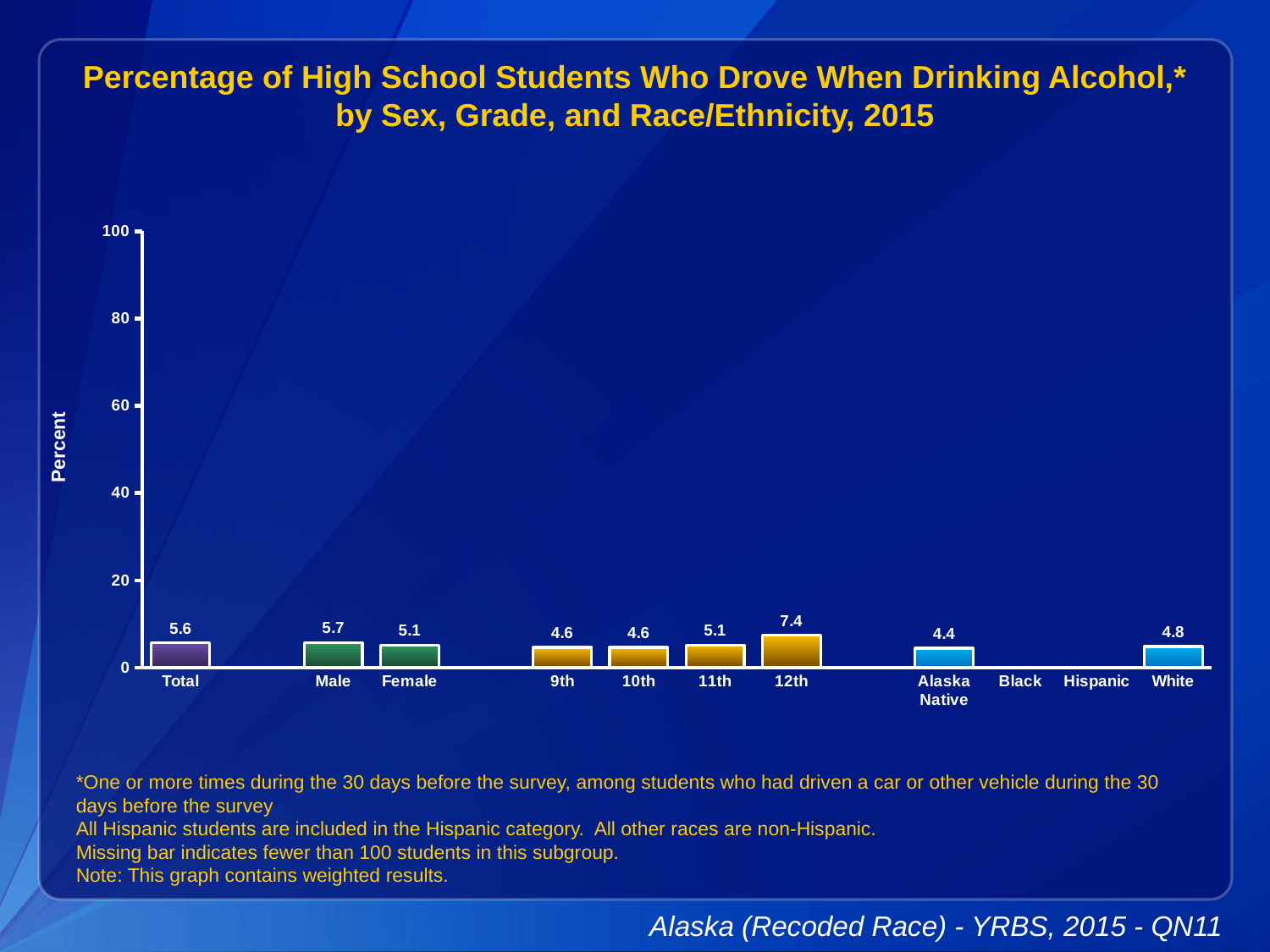
Which is larger, the value for 11th grade or the value for 12th grade? 12th Is the value for White greater or less than 20? less What is the label of the y axis? Percent Which categories have no bar shown? Black and Hispanic Which category has the highest value? 12th What is the value for 12th grade? 7.4 How many categories have a bar shown on the chart? 9 What is the value for Total? 5.6 What kind of chart is shown on the slide? bar chart Which category has the lowest value among those with a bar shown? Alaska Native What is the value for Alaska Native? 4.4 What is the difference between the values for Male and Female? 0.6